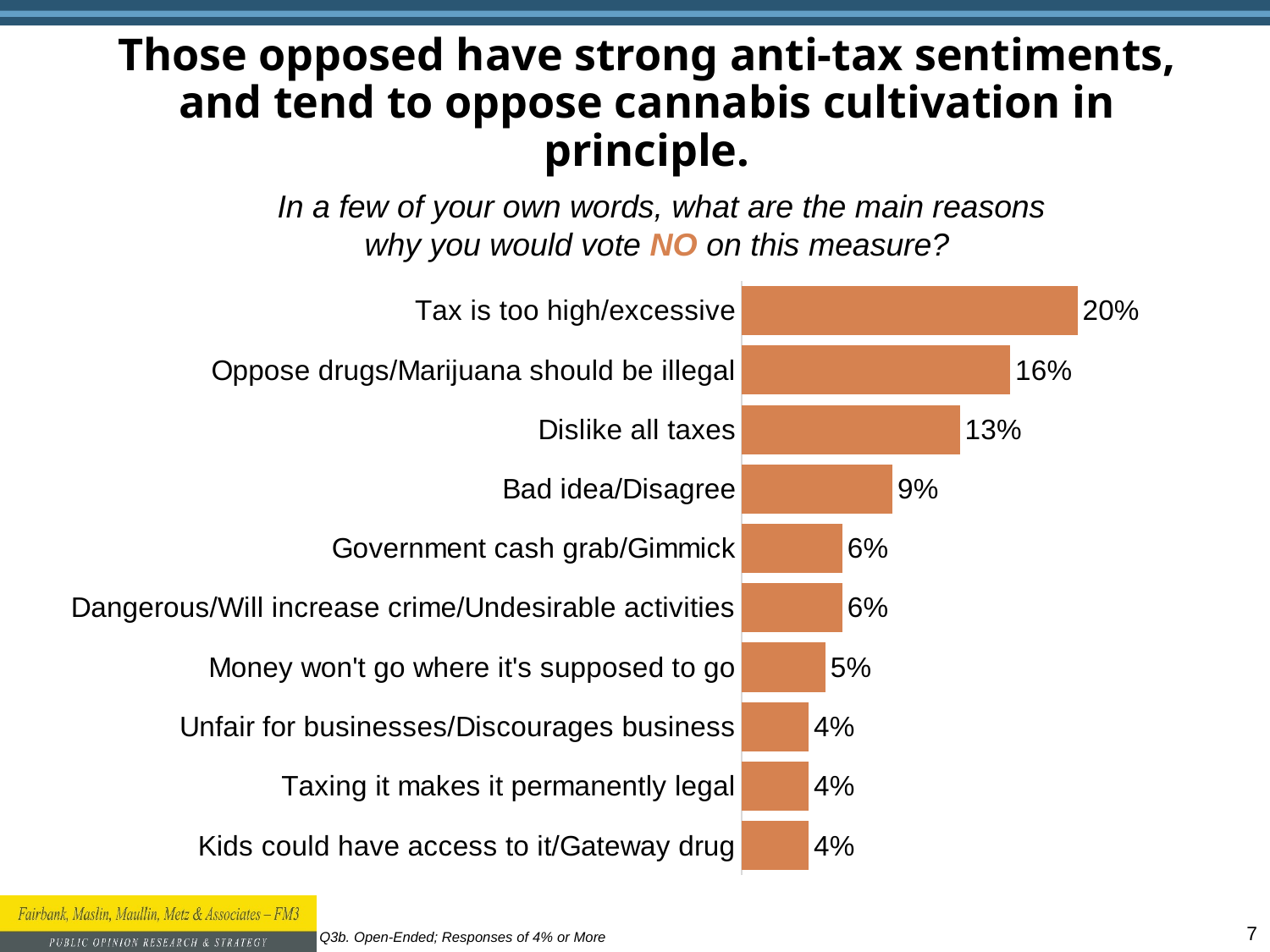
What percentage gave "Government cash grab/Gimmick" as a reason? 6% How many reasons are shown in the chart? 10 How many reasons are shown with a value of 4%? 3 Which is larger: "Bad idea/Disagree" or "Money won't go where it's supposed to go"? Bad idea/Disagree What is the value for "Dislike all taxes"? 13% What percentage of respondents said "Tax is too high/excessive"? 20% Which reason has the highest percentage? Tax is too high/excessive What is the difference between "Tax is too high/excessive" and "Oppose drugs/Marijuana should be illegal"? 4 percentage points What is the difference between "Dislike all taxes" and "Bad idea/Disagree"? 4 percentage points What colour are the bars in the chart? Orange What kind of chart is shown on the slide? Bar chart What is the value for "Oppose drugs/Marijuana should be illegal"? 16%